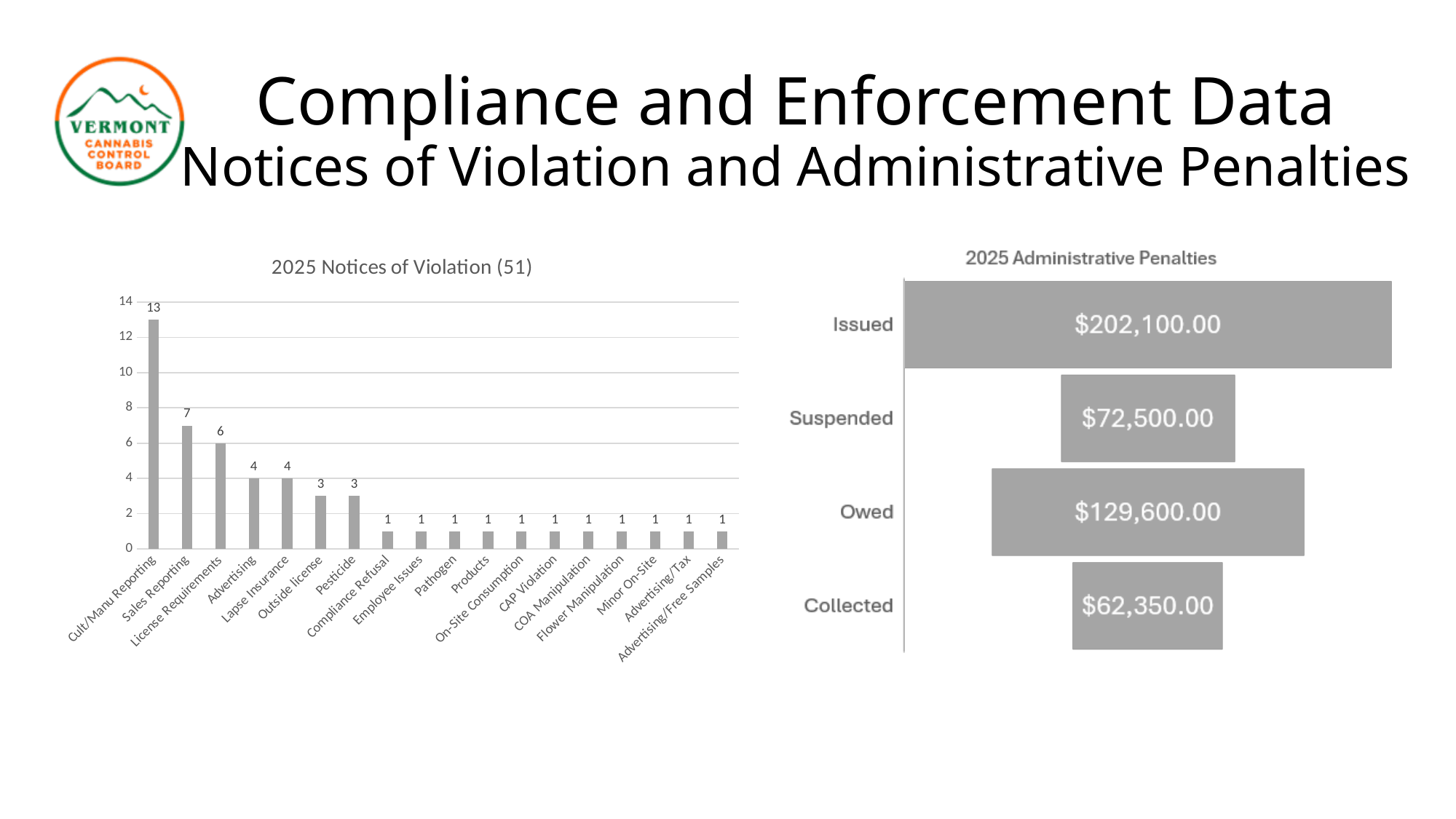
In the 2025 Notices of Violation chart, which is larger, Outside license or Advertising? Advertising In the 2025 Administrative Penalties chart, what is the difference between Owed and Suspended? $57,100.00 How many categories are shown in the 2025 Notices of Violation chart? 18 In the 2025 Notices of Violation chart, what is the difference between Cult/Manu Reporting and License Requirements? 7 In the 2025 Administrative Penalties chart, what is the value for Collected? $62,350.00 In the 2025 Notices of Violation chart, which category has the highest number of notices? Cult/Manu Reporting In the 2025 Administrative Penalties chart, what is the value for Issued? $202,100.00 In the 2025 Administrative Penalties chart, which category has the lowest value? Collected In the 2025 Notices of Violation chart, do the values rise or fall from left to right along the x axis? fall What kind of chart is the 2025 Administrative Penalties chart? bar chart In the 2025 Notices of Violation chart, how many notices were issued for Cult/Manu Reporting? 13 In the 2025 Notices of Violation chart, what is the value for Sales Reporting? 7